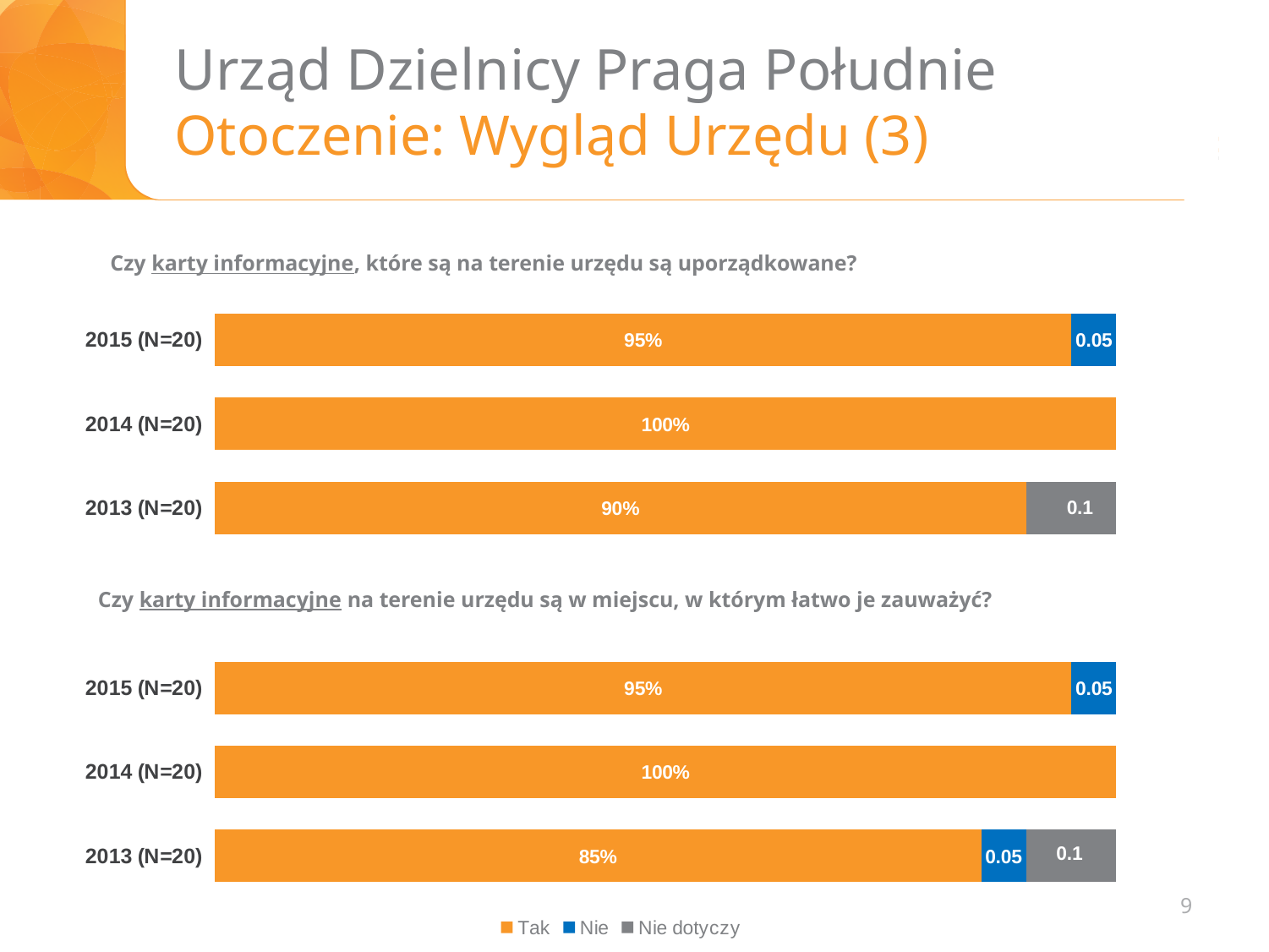
In the bottom chart (karty informacyjne łatwo je zauważyć), which year has the lowest 'Tak' value? 2013 (N=20) In the top chart (karty informacyjne uporządkowane), which year has the highest 'Tak' value? 2014 (N=20) How many series does the legend at the bottom of the slide list? 3 How many year categories does the top chart (karty informacyjne uporządkowane) show? 3 In the top chart (karty informacyjne uporządkowane), what is the difference between the 'Tak' values for 2014 and 2013? 10% In the top chart (karty informacyjne uporządkowane), what is the 'Nie dotyczy' value for 2013 (N=20)? 0.1 What kind of chart is the bottom chart (karty informacyjne łatwo je zauważyć)? Stacked bar chart In the top chart (karty informacyjne uporządkowane), what is the 'Tak' value for 2015 (N=20)? 95% In the bottom chart (karty informacyjne łatwo je zauważyć), is the 'Tak' value for 2015 larger or smaller than for 2013? larger In the bottom chart (karty informacyjne łatwo je zauważyć), what is the 'Nie' value for 2015 (N=20)? 0.05 In the bottom chart (karty informacyjne łatwo je zauważyć), what is the 'Tak' value for 2013 (N=20)? 85% In the bottom chart (karty informacyjne łatwo je zauważyć), what is the difference between the 'Tak' values for 2015 and 2013? 10%